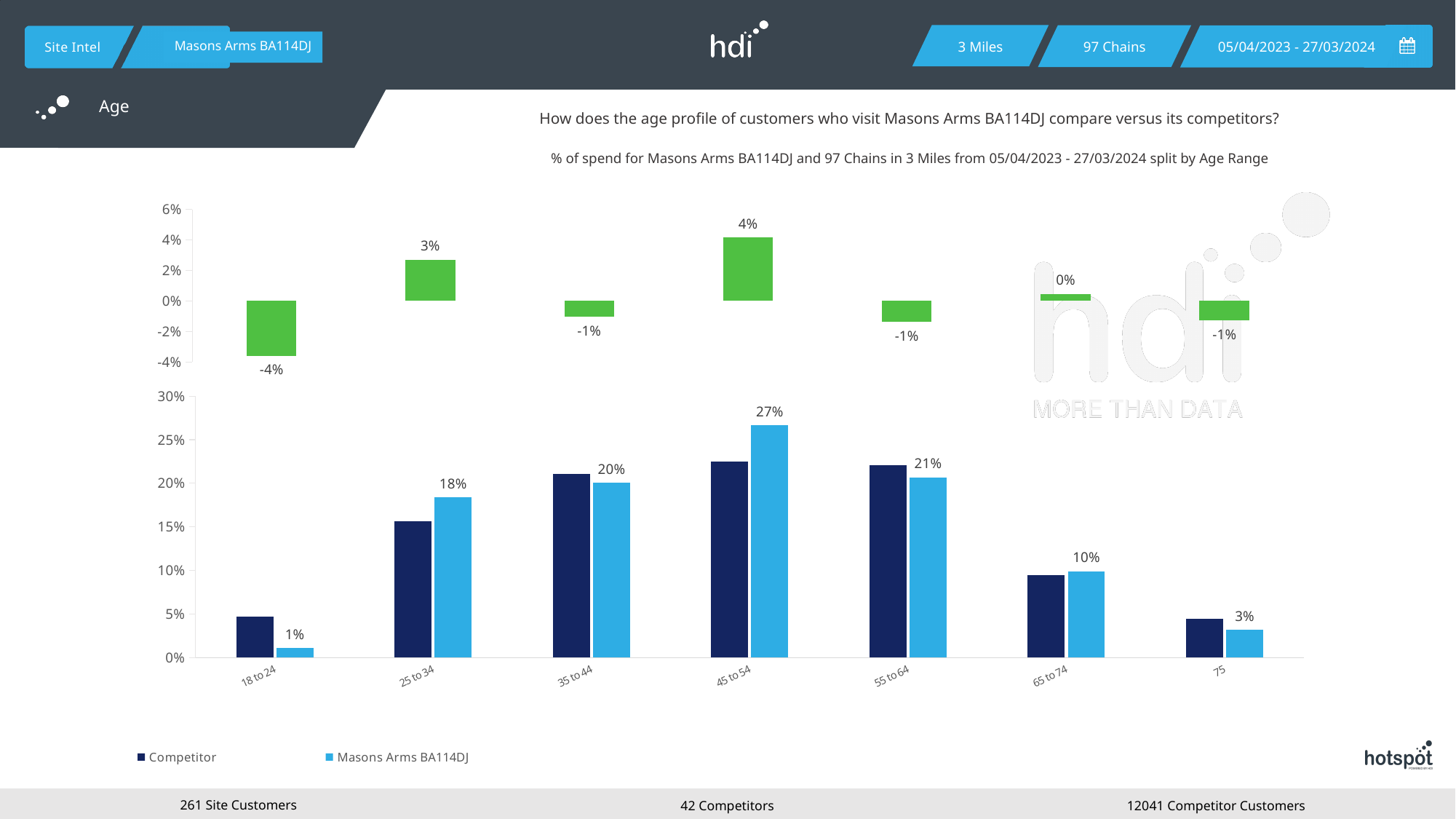
How many series does the legend of the bottom bar chart list? 2 In the bottom bar chart, which is larger for the 45 to 54 age range: the Competitor bar or the Masons Arms BA114DJ bar? Masons Arms BA114DJ In the bottom bar chart, which age range has the highest value for Masons Arms BA114DJ? 45 to 54 In the bottom bar chart, what is the difference between the Masons Arms BA114DJ values for 45 to 54 and 65 to 74? 17% In the bottom bar chart, what is the value for Masons Arms BA114DJ in the 45 to 54 age range? 27% In the top chart of green bars, which age range has the highest value? 45 to 54 In the bottom bar chart, which age range has the lowest value for Masons Arms BA114DJ? 18 to 24 In the bottom bar chart, is the Competitor value for 35 to 44 greater or less than 20%? greater In the top chart of green bars, what is the value for the 18 to 24 age range? -4% How many age range categories are shown on the x axis of the bottom bar chart? 7 In the bottom bar chart, what is the value for Masons Arms BA114DJ in the 18 to 24 age range? 1%